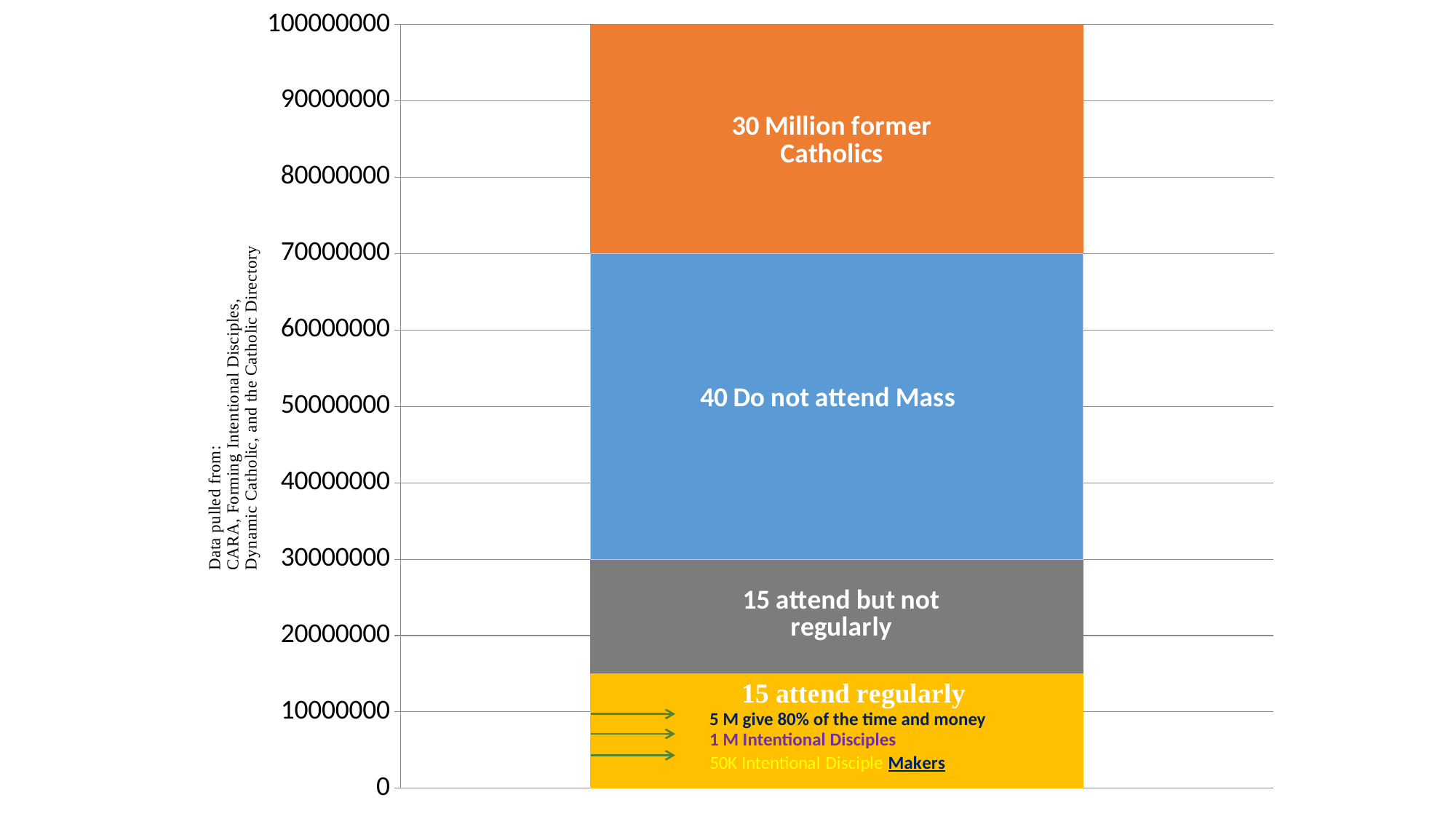
What colour is the segment labelled '15 attend regularly'? yellow Is the top of the 'Do not attend Mass' segment greater or less than 60000000 on the y axis? greater According to the y-axis label, what is the first source the data was pulled from? CARA What is the difference between the 'Do not attend Mass' value (40) and the 'former Catholics' value (30)? 10 How many segments make up the stacked bar? 4 What kind of chart is shown on the slide? stacked bar chart What number is printed on the blue segment labelled 'Do not attend Mass'? 40 How many former Catholics does the orange segment label state? 30 Million What value on the y axis does the top of the stacked bar reach? 100000000 Which is larger: the 'Do not attend Mass' segment or the 'former Catholics' segment? Do not attend Mass What number is printed on the gray segment labelled 'attend but not regularly'? 15 Which segment of the stacked bar is the largest? 40 Do not attend Mass